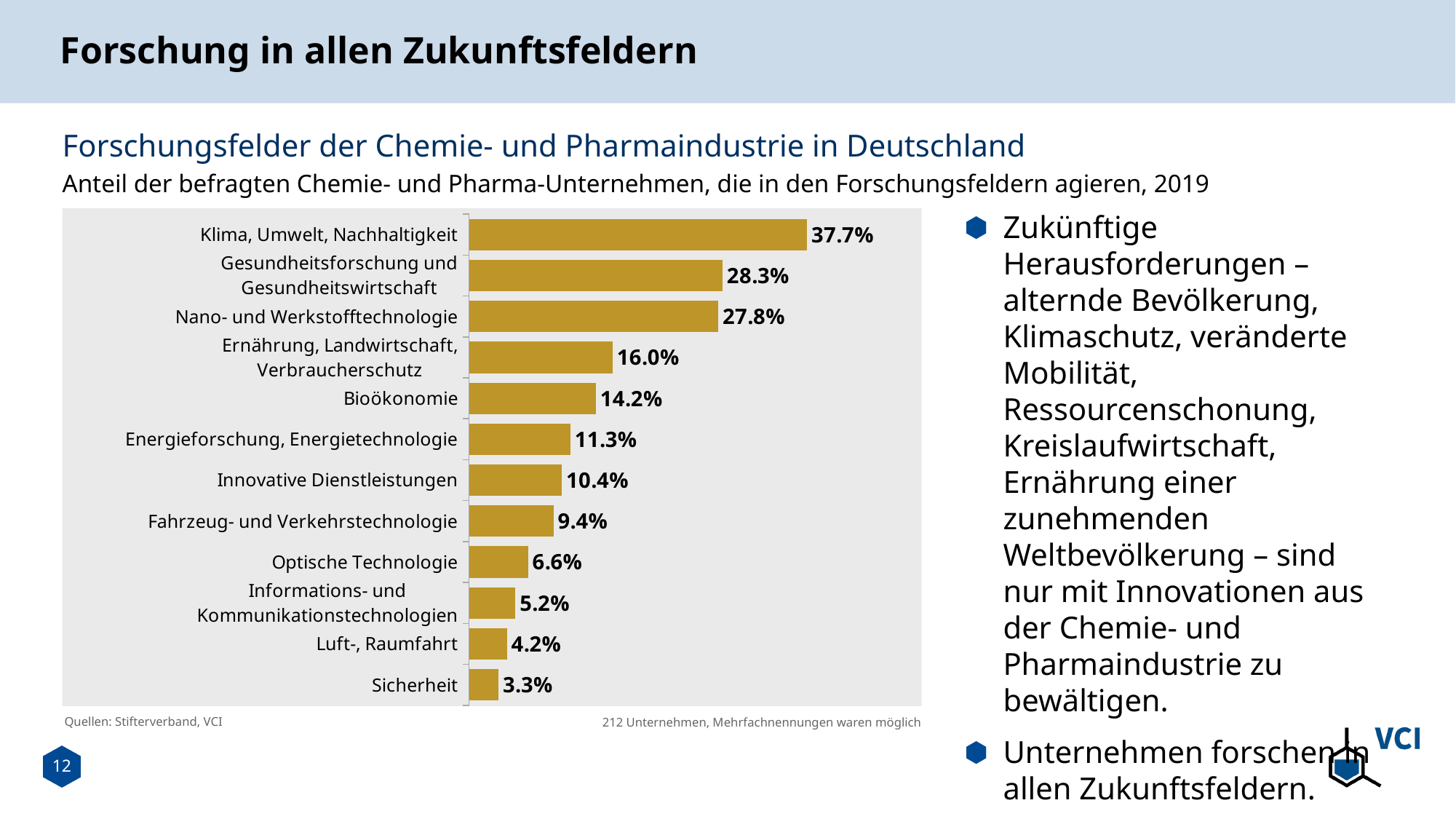
What is the value for Klima, Umwelt, Nachhaltigkeit? 37.7% What colour are the bars in the chart? Gold Which category has the lowest value? Sicherheit What kind of chart is shown on the slide? Bar chart What is the difference between the values for Gesundheitsforschung und Gesundheitswirtschaft and Nano- und Werkstofftechnologie? 0.5% What is the value for Luft-, Raumfahrt? 4.2% What is the title of the chart? Forschungsfelder der Chemie- und Pharmaindustrie in Deutschland Which is larger, the value for Energieforschung, Energietechnologie or the value for Innovative Dienstleistungen? Energieforschung, Energietechnologie Which category has the highest value? Klima, Umwelt, Nachhaltigkeit What is the difference between the values for Klima, Umwelt, Nachhaltigkeit and Sicherheit? 34.4% How many categories are shown in the chart? 12 What is the value for Bioökonomie? 14.2%